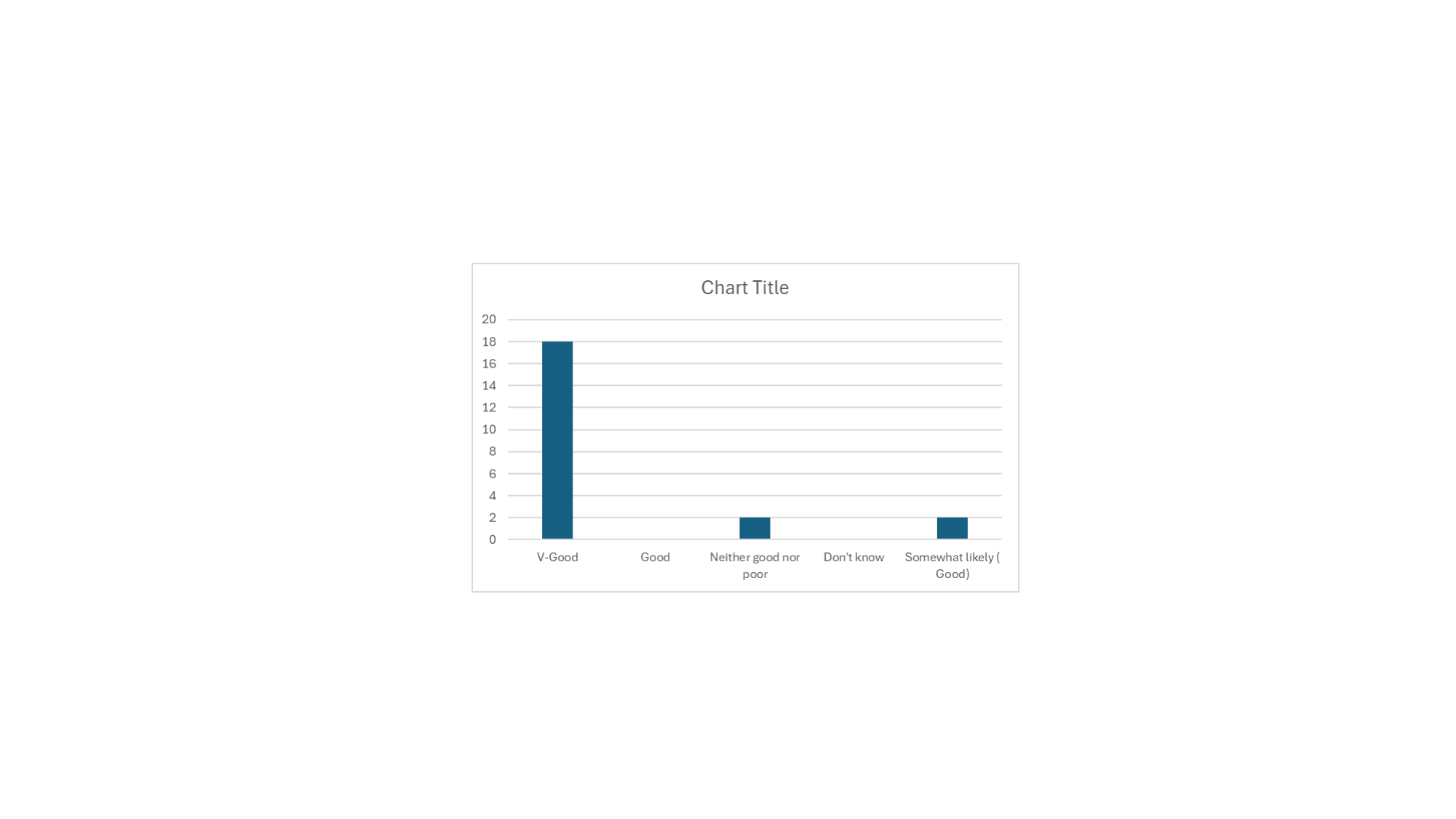
What kind of chart is shown on the slide? bar chart Is the value for Neither good nor poor greater or less than 4? less What is the value for Neither good nor poor? 2 How many categories are shown on the x axis? 5 What is the highest value shown on the vertical axis? 20 What is the value for Somewhat likely ( Good)? 2 Is the value for V-Good greater or less than 10? greater What is the difference between the values for V-Good and Neither good nor poor? 16 Which category has the highest value? V-Good What is the title of the chart? Chart Title What is the value for V-Good? 18 Which is larger, the value for V-Good or the value for Somewhat likely ( Good)? V-Good